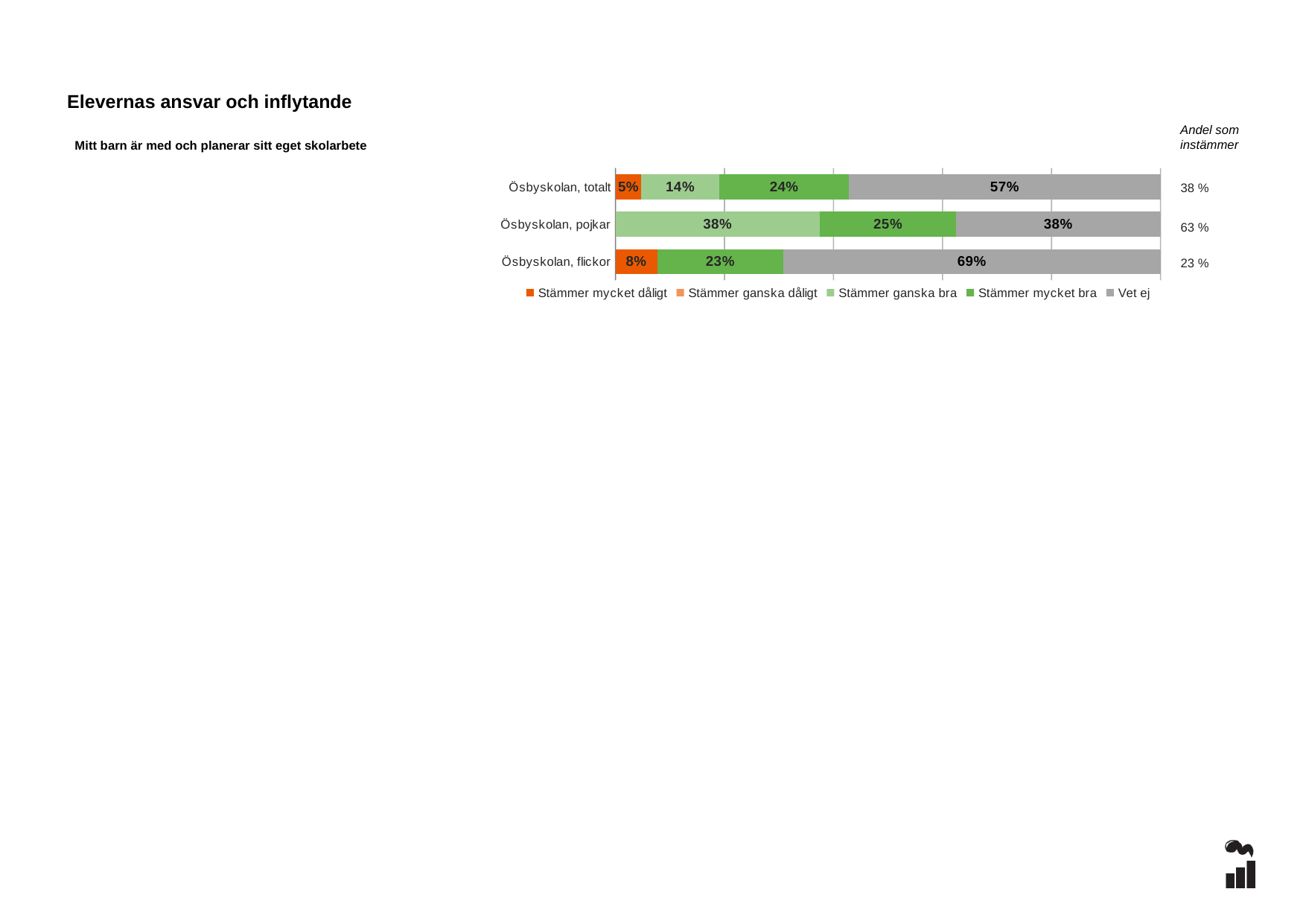
What is the "Stämmer mycket dåligt" value for Ösbyskolan, flickor? 8% What kind of chart is shown on the slide? Stacked bar chart Which is larger: the "Stämmer mycket bra" value for Ösbyskolan, pojkar or for Ösbyskolan, flickor? Ösbyskolan, pojkar Which category has the highest "Vet ej" value? Ösbyskolan, flickor What is the "Andel som instämmer" value shown for Ösbyskolan, pojkar? 63 % How many categories (rows) does the chart show? 3 What is the "Vet ej" value for Ösbyskolan, totalt? 57% What is the "Stämmer ganska bra" value for Ösbyskolan, pojkar? 38% What is the "Stämmer mycket bra" value for Ösbyskolan, totalt? 24% How many series does the legend list? 5 What is the difference between the "Vet ej" values for Ösbyskolan, flickor and Ösbyskolan, pojkar? 31% Which category has the lowest "Vet ej" value? Ösbyskolan, pojkar